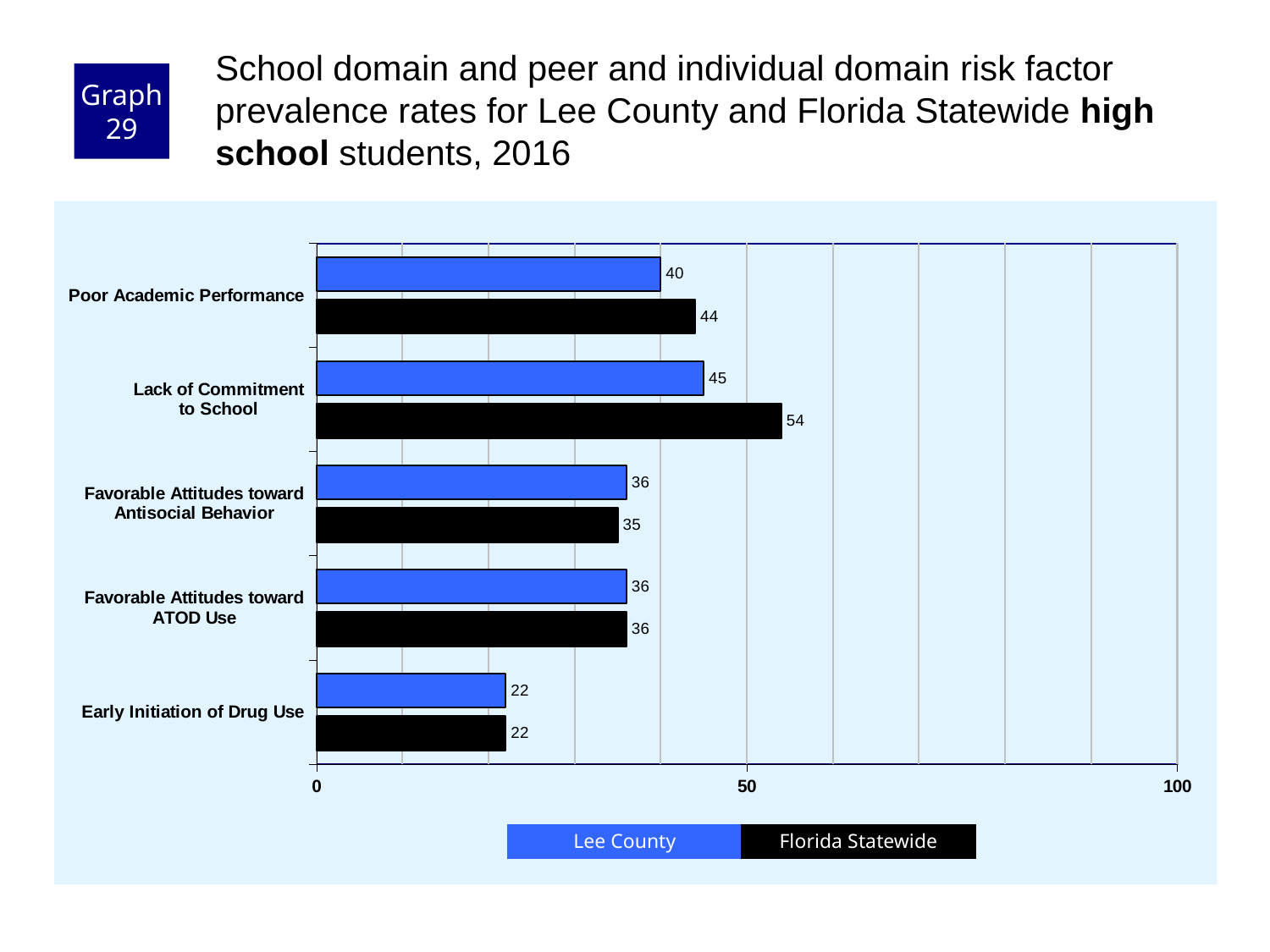
Is the Florida Statewide value for Lack of Commitment to School greater or less than 50? greater What is the Lee County value for Poor Academic Performance? 40 What is the Florida Statewide value for Lack of Commitment to School? 54 How many risk factor categories are shown on the chart? 5 What is the difference between the Florida Statewide and Lee County values for Lack of Commitment to School? 9 Which is larger for Poor Academic Performance, the Lee County value or the Florida Statewide value? Florida Statewide What is the Florida Statewide value for Favorable Attitudes toward Antisocial Behavior? 35 Which category has the lowest Lee County value? Early Initiation of Drug Use What is the Lee County value for Early Initiation of Drug Use? 22 How many series does the legend list? 2 Which category has the highest Florida Statewide value? Lack of Commitment to School What kind of chart is shown on the slide? bar chart